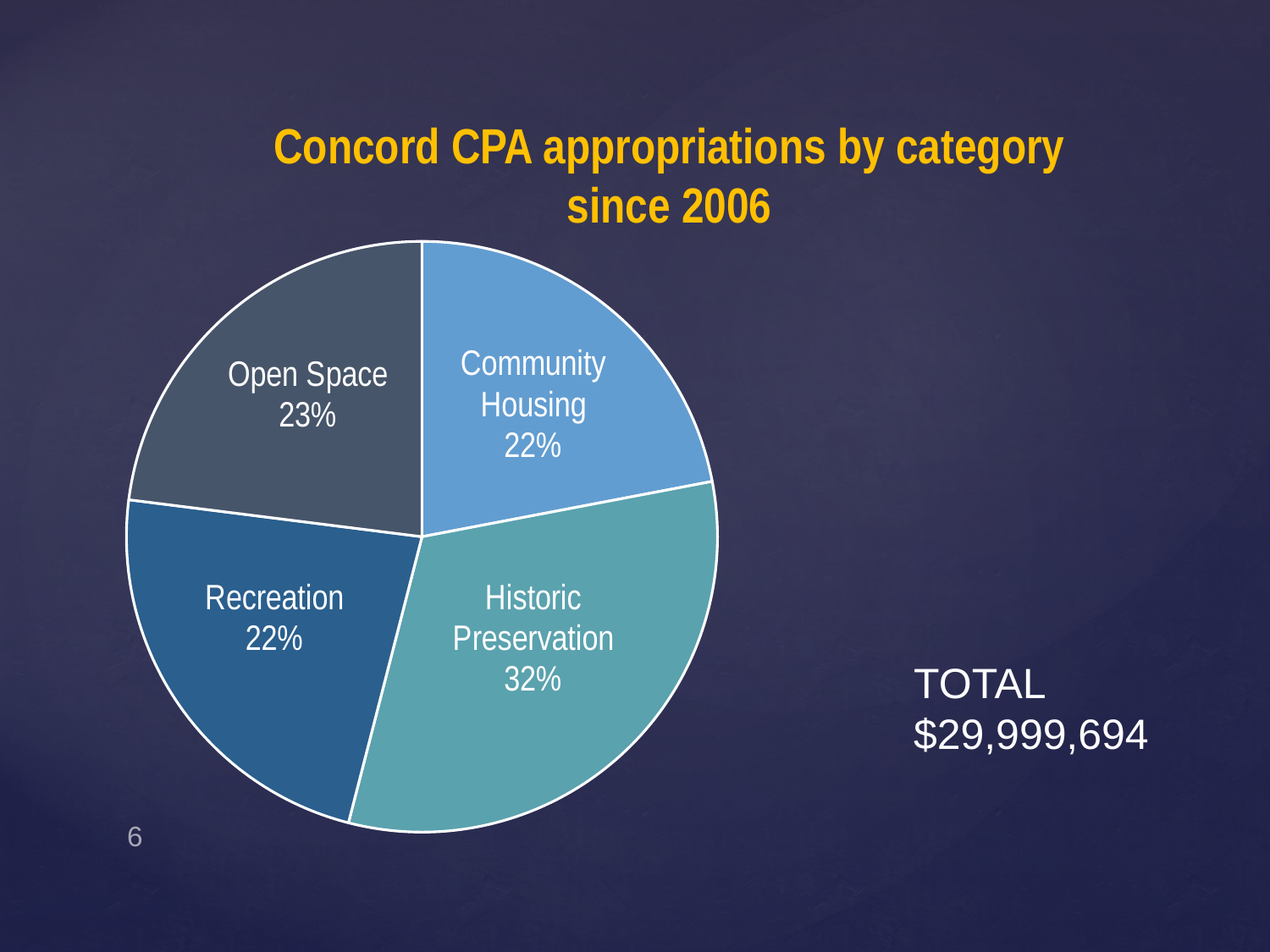
What is the title of the chart? Concord CPA appropriations by category since 2006 What share of Concord CPA appropriations went to Open Space? 23% What type of chart is shown on the slide? pie chart Which category received the largest share of appropriations? Historic Preservation What is the difference in percentage points between Open Space and Recreation? 1 What total dollar amount is shown next to the chart? $29,999,694 What is the difference in percentage points between Historic Preservation and Open Space? 9 What share of Concord CPA appropriations went to Recreation? 22% What share of Concord CPA appropriations went to Historic Preservation? 32% Which is larger, the share for Historic Preservation or the share for Community Housing? Historic Preservation What share of Concord CPA appropriations went to Community Housing? 22% How many categories are shown in the pie chart? 4